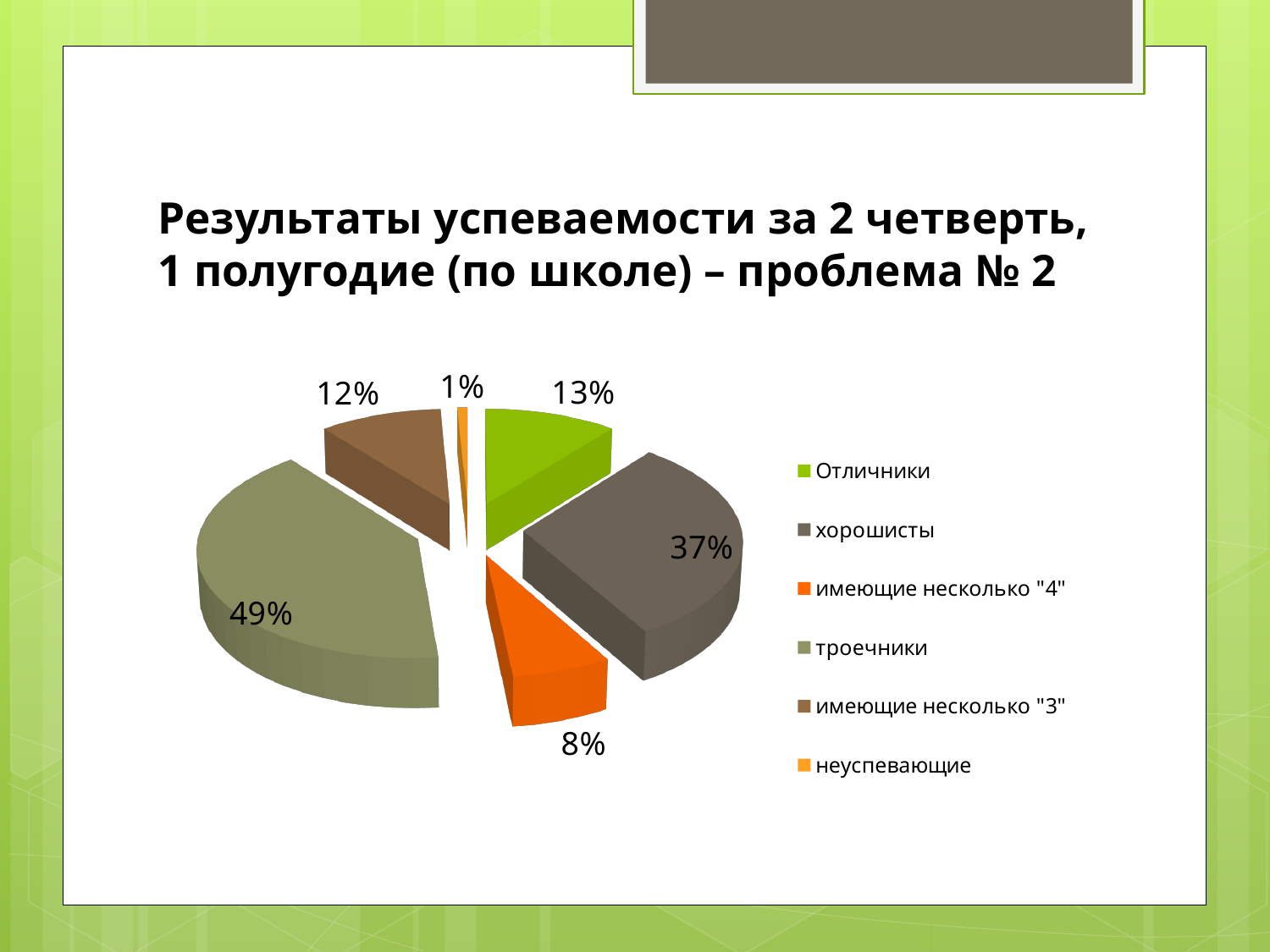
What kind of chart is shown on the slide? pie chart Which slice is larger: "Отличники" or "имеющие несколько "3""? Отличники What percentage is shown for the "троечники" slice? 49% Which category has the largest slice of the pie? троечники What is the difference in percentage points between "троечники" and "хорошисты"? 12 What percentage is shown for the slice "имеющие несколько "4""? 8% How many categories does the legend list? 6 Which category has the smallest slice of the pie? неуспевающие What percentage is shown for the "хорошисты" slice? 37% What percentage is shown for the "Отличники" slice? 13% What percentage is shown for the "неуспевающие" slice? 1% What colour is the "Отличники" slice? green